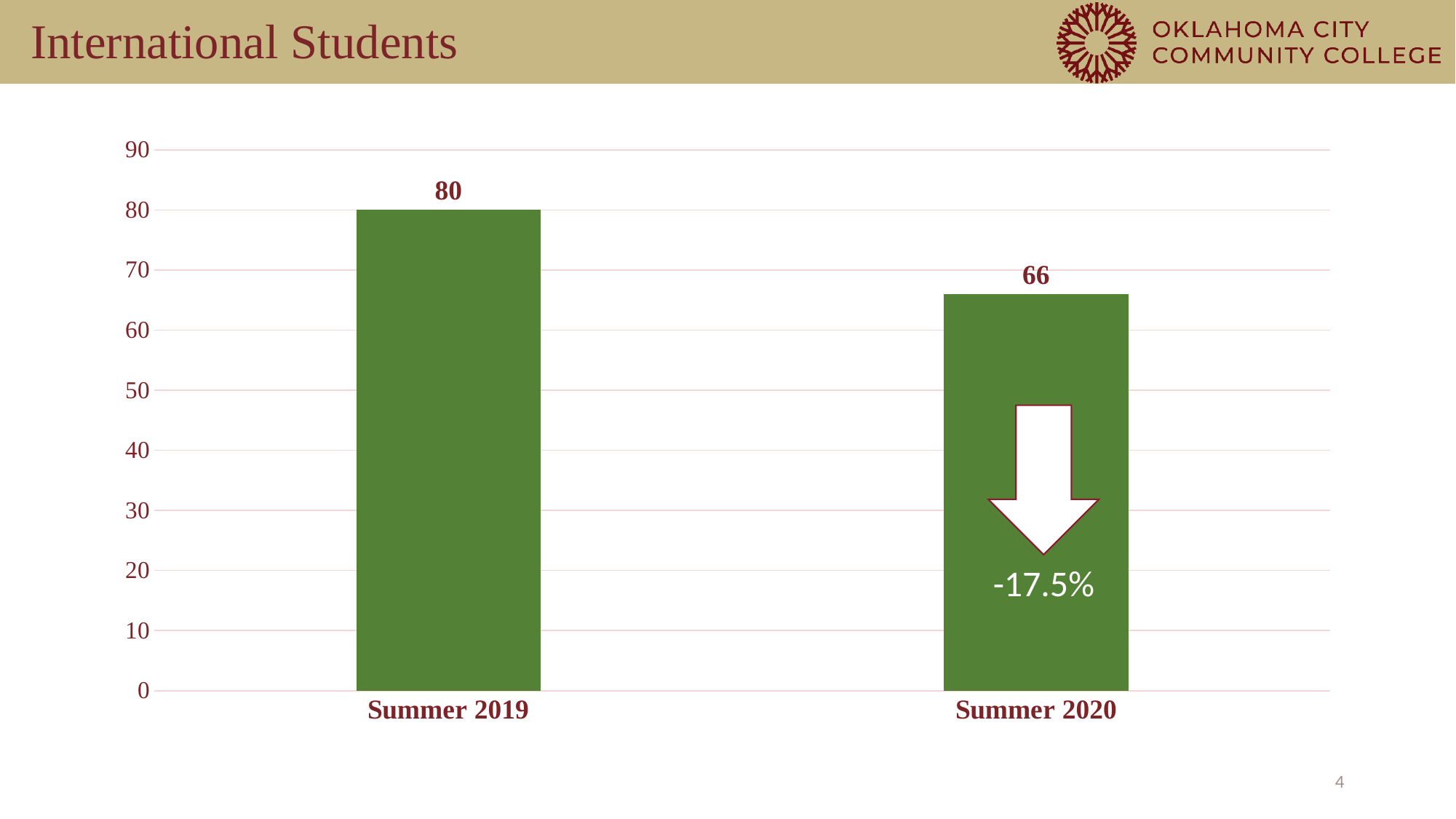
Which is larger, the value for Summer 2019 or Summer 2020? Summer 2019 Is the value for Summer 2020 greater or less than 70? less What is the difference between the Summer 2019 and Summer 2020 values? 14 Which category has the highest value? Summer 2019 Do the values rise or fall from Summer 2019 to Summer 2020? fall What is the value for Summer 2020? 66 How many categories are shown on the x axis? 2 What kind of chart is shown on the slide? bar chart Which category has the lowest value? Summer 2020 What percentage change is annotated on the Summer 2020 bar? -17.5% What is the value for Summer 2019? 80 What is the title of the slide containing the chart? International Students